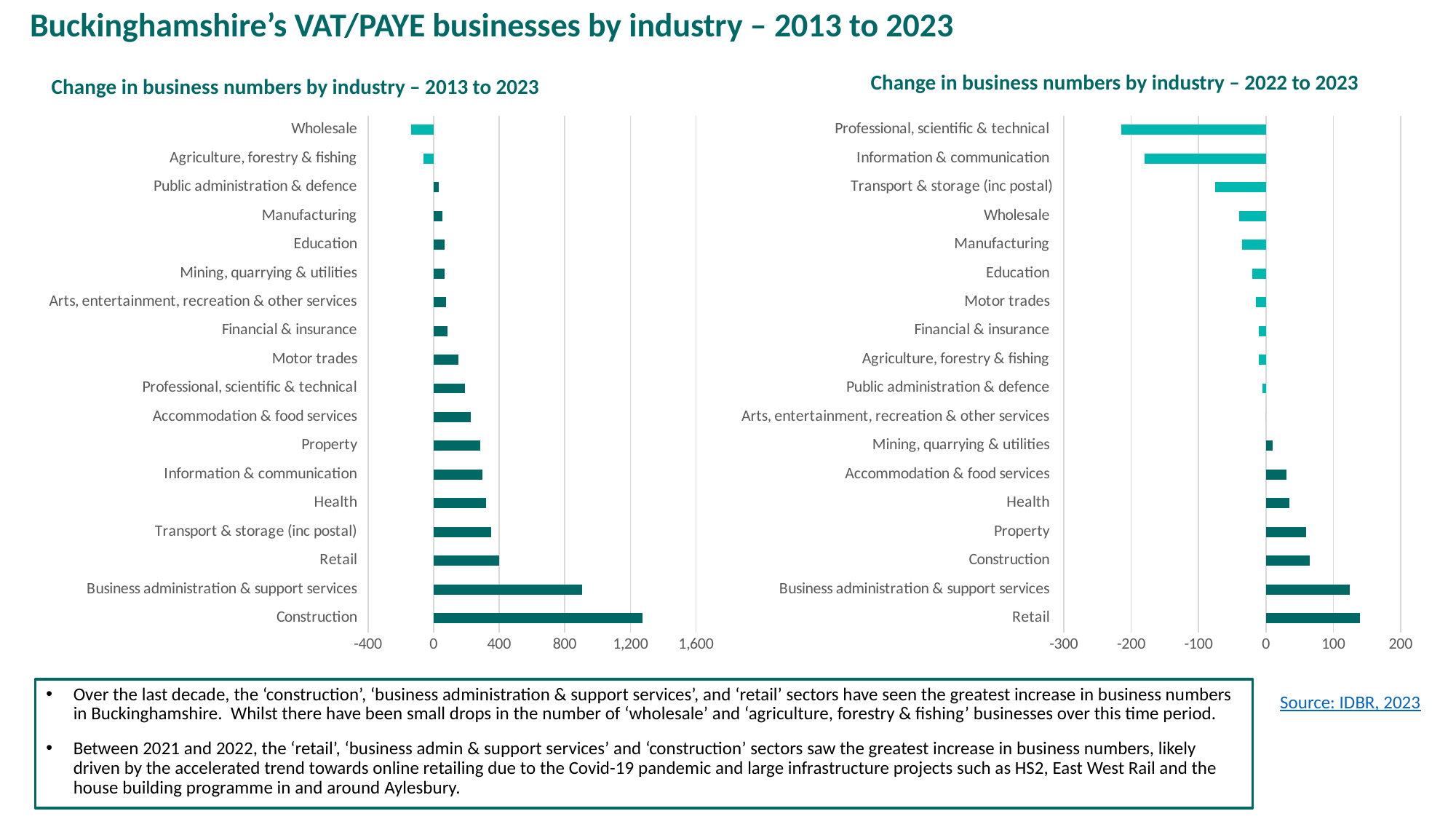
In the 'Change in business numbers by industry – 2013 to 2023' chart, which industry has the lowest value? Wholesale In the 'Change in business numbers by industry – 2013 to 2023' chart, is the value for Construction greater or less than 1,200? greater In the 'Change in business numbers by industry – 2022 to 2023' chart, which is larger: the value for Retail or for Construction? Retail In the 'Change in business numbers by industry – 2022 to 2023' chart, which industry has the lowest value? Professional, scientific & technical In the 'Change in business numbers by industry – 2022 to 2023' chart, which industry has the highest value? Retail In the 'Change in business numbers by industry – 2013 to 2023' chart, which is larger: the value for Construction or for Business administration & support services? Construction In the 'Change in business numbers by industry – 2022 to 2023' chart, is the value for Construction greater or less than 100? less In the 'Change in business numbers by industry – 2022 to 2023' chart, is the value for Professional, scientific & technical greater or less than -200? less What type of chart is the 'Change in business numbers by industry – 2013 to 2023' chart? Bar chart In the 'Change in business numbers by industry – 2013 to 2023' chart, which industry has the highest value? Construction In the 'Change in business numbers by industry – 2013 to 2023' chart, how many industries are plotted? 18